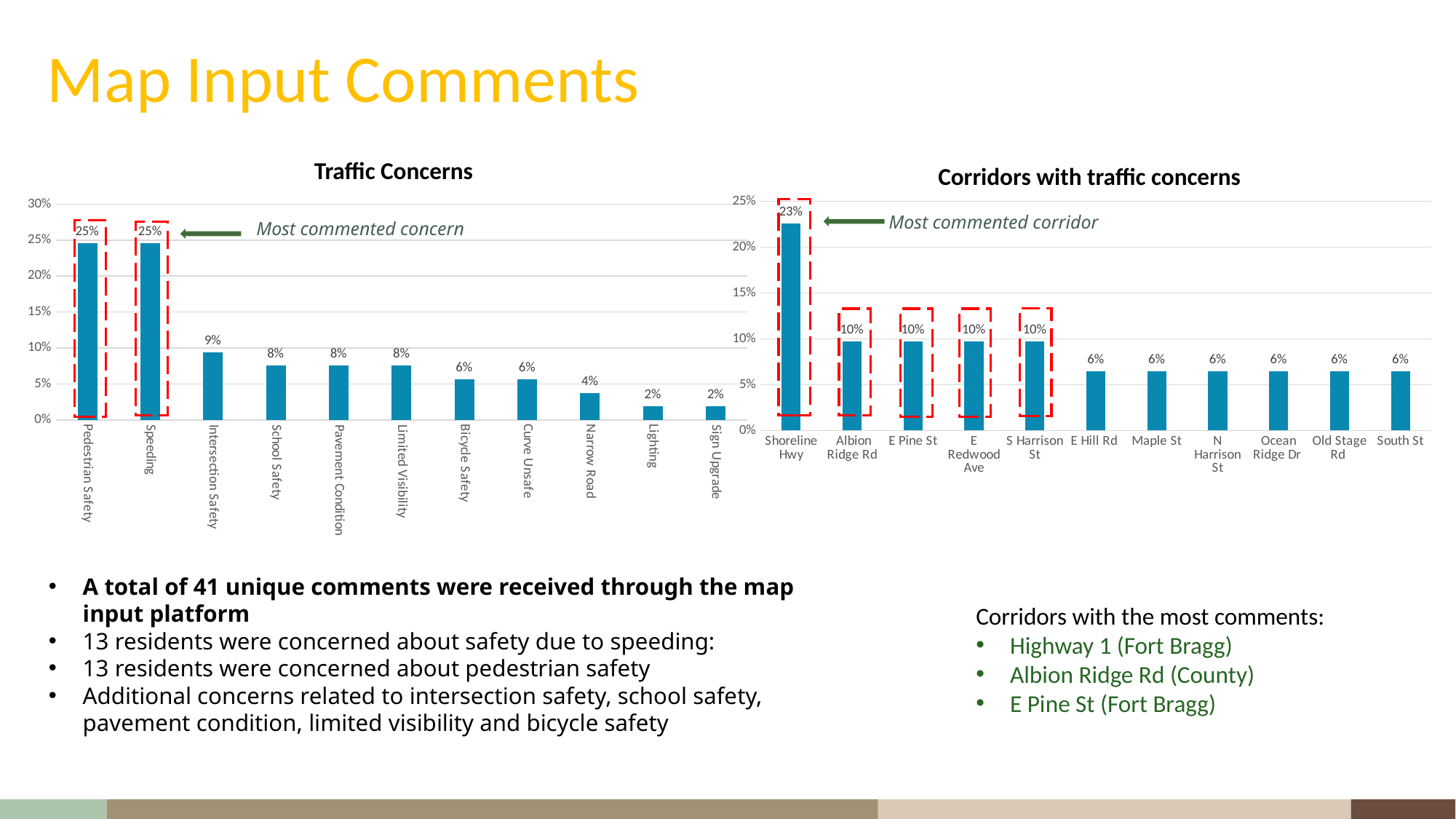
In the 'Corridors with traffic concerns' chart, what is the value for Shoreline Hwy? 23% In the 'Corridors with traffic concerns' chart, what is the difference between the values for Shoreline Hwy and Albion Ridge Rd? 13% In the 'Corridors with traffic concerns' chart, how many corridors are shown on the x axis? 11 What type of chart is the 'Corridors with traffic concerns' chart? Bar chart In the 'Traffic Concerns' chart, what is the difference between the values for Speeding and School Safety? 17% In the 'Traffic Concerns' chart, what is the value for Narrow Road? 4% In the 'Traffic Concerns' chart, which category has the lowest value, Lighting or Bicycle Safety? Lighting In the 'Traffic Concerns' chart, is the value for Pedestrian Safety greater or less than 20%? greater In the 'Traffic Concerns' chart, how many categories are shown on the x axis? 11 In the 'Corridors with traffic concerns' chart, what is the value for Maple St? 6% In the 'Traffic Concerns' chart, what is the value for Intersection Safety? 9% In the 'Corridors with traffic concerns' chart, which corridor has the highest value? Shoreline Hwy